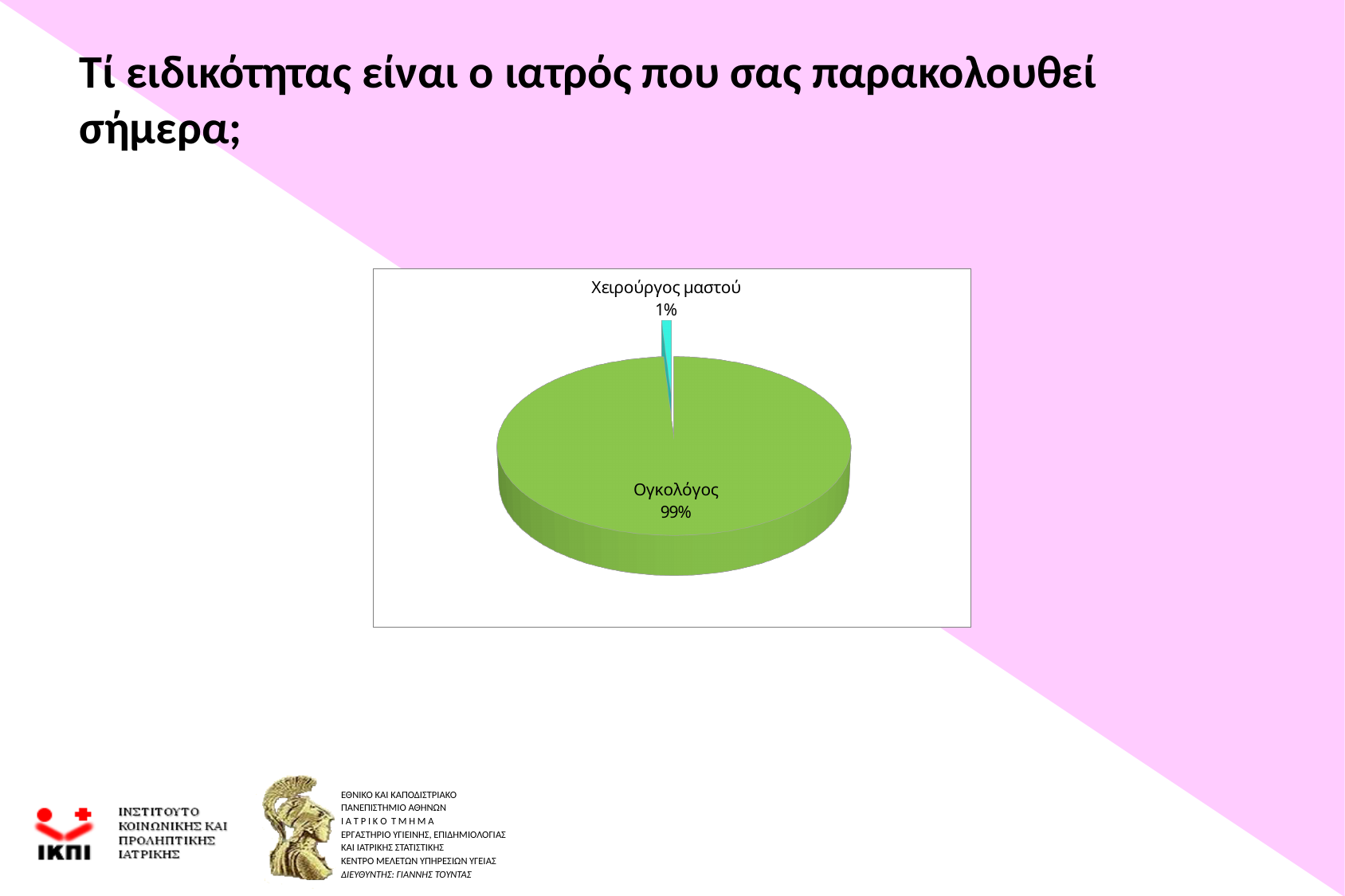
What is the difference in percentage points between Ογκολόγος and Χειρούργος μαστού? 98 What colour is the slice for Ογκολόγος? green Which category has the smallest slice of the pie? Χειρούργος μαστού How many categories are shown in the pie chart? 2 What share of the pie does Χειρούργος μαστού have? 1% What kind of chart is shown on the slide? pie chart Which is larger, the share for Ογκολόγος or the share for Χειρούργος μαστού? Ογκολόγος What is the title of the slide containing the pie chart? Τί ειδικότητας είναι ο ιατρός που σας παρακολουθεί σήμερα; Which category has the largest slice of the pie? Ογκολόγος What share of the pie does Ογκολόγος have? 99%